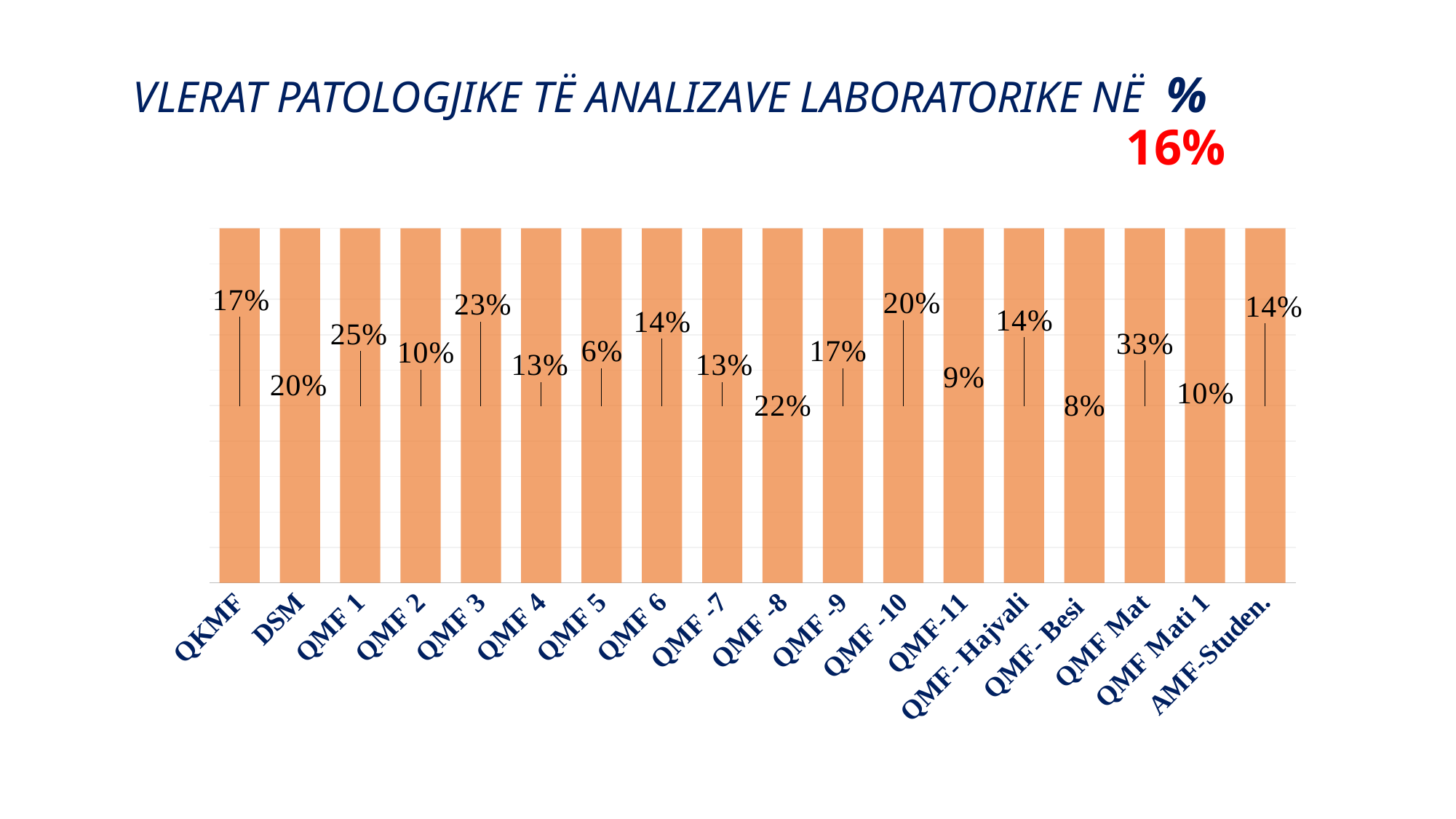
What is the value shown for QMF 1? 25% What is the value shown for QMF 5? 6% What percentage is highlighted in red next to the chart title? 16% What kind of chart is shown on the slide? Bar chart Which category has the highest labelled value? QMF Mat How many categories are shown on the x axis? 18 Which has a larger value, QMF 3 or QMF 2? QMF 3 What is the value shown for QMF- Besi? 8% What is the value shown for QMF Mat? 33% What is the difference between the values for QMF Mat and QMF 5? 27% Which category has the lowest labelled value? QMF 5 What is the value shown for QMF -8? 22%